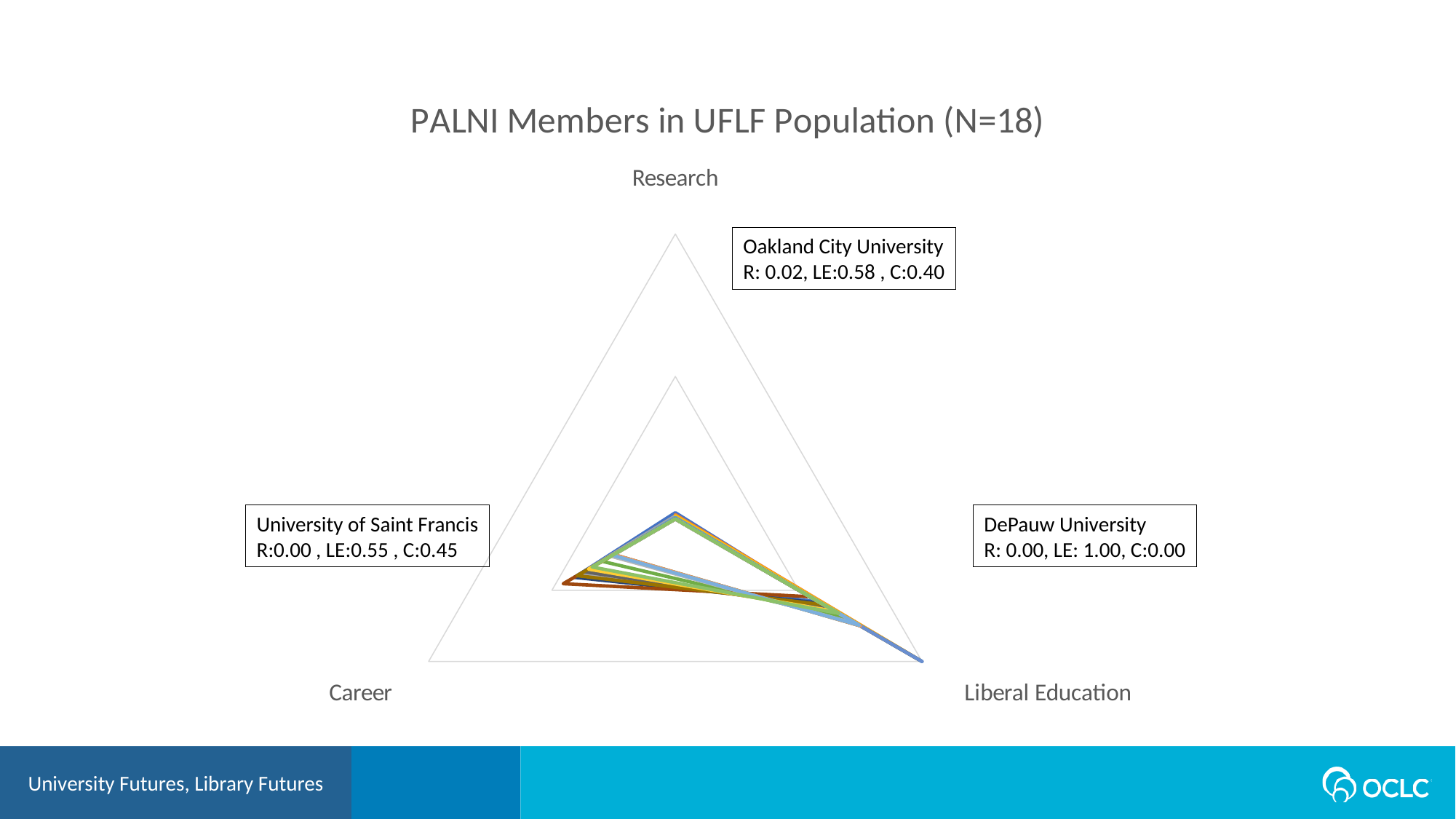
What is the Career (C) value for Oakland City University? 0.40 What is the Liberal Education (LE) value for DePauw University? 1.00 Which of the three labelled universities has the highest Liberal Education (LE) value? DePauw University Which is larger: the Career value for University of Saint Francis or the Career value for Oakland City University? University of Saint Francis How many axes (categories) does the radar chart have? 3 What is the title of the chart? PALNI Members in UFLF Population (N=18) What are the three axis labels on the radar chart? Research, Career, Liberal Education What is the Research (R) value for Oakland City University? 0.02 What is the Liberal Education (LE) value for Oakland City University? 0.58 What is the Career (C) value for University of Saint Francis? 0.45 What is the difference between the Liberal Education values of DePauw University and University of Saint Francis? 0.45 What kind of chart is shown on the slide? Radar chart